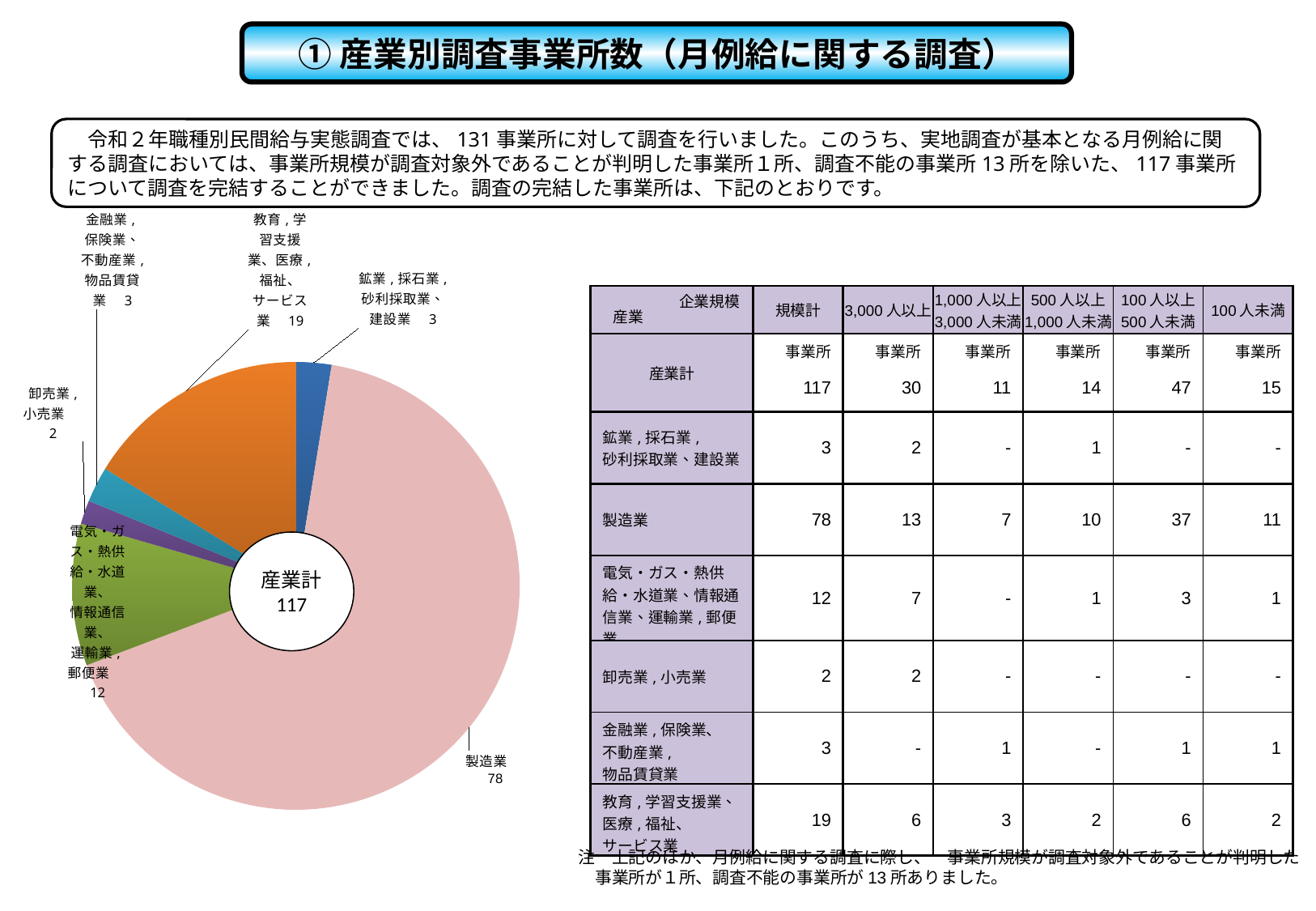
What total is shown in the centre of the pie chart for 産業計? 117 Which is larger in the pie chart: 電気・ガス・熱供給・水道業、情報通信業、運輸業,郵便業 or 鉱業,採石業,砂利採取業、建設業? 電気・ガス・熱供給・水道業、情報通信業、運輸業,郵便業 In the pie chart, what is the value for 電気・ガス・熱供給・水道業、情報通信業、運輸業,郵便業? 12 In the pie chart, what is the value for 卸売業,小売業? 2 What share of the pie chart total does 製造業 represent, as a fraction of 117? 78/117 Which category has the largest slice in the pie chart? 製造業 What is the difference between the values for 製造業 and 教育,学習支援業、医療、福祉、サービス業 in the pie chart? 59 In the pie chart, what is the value for 製造業? 78 Which category has the smallest slice in the pie chart? 卸売業,小売業 What type of chart is shown on the left of the slide? pie chart How many categories (slices) does the pie chart have? 6 In the pie chart, what is the value for 教育,学習支援業、医療、福祉、サービス業? 19